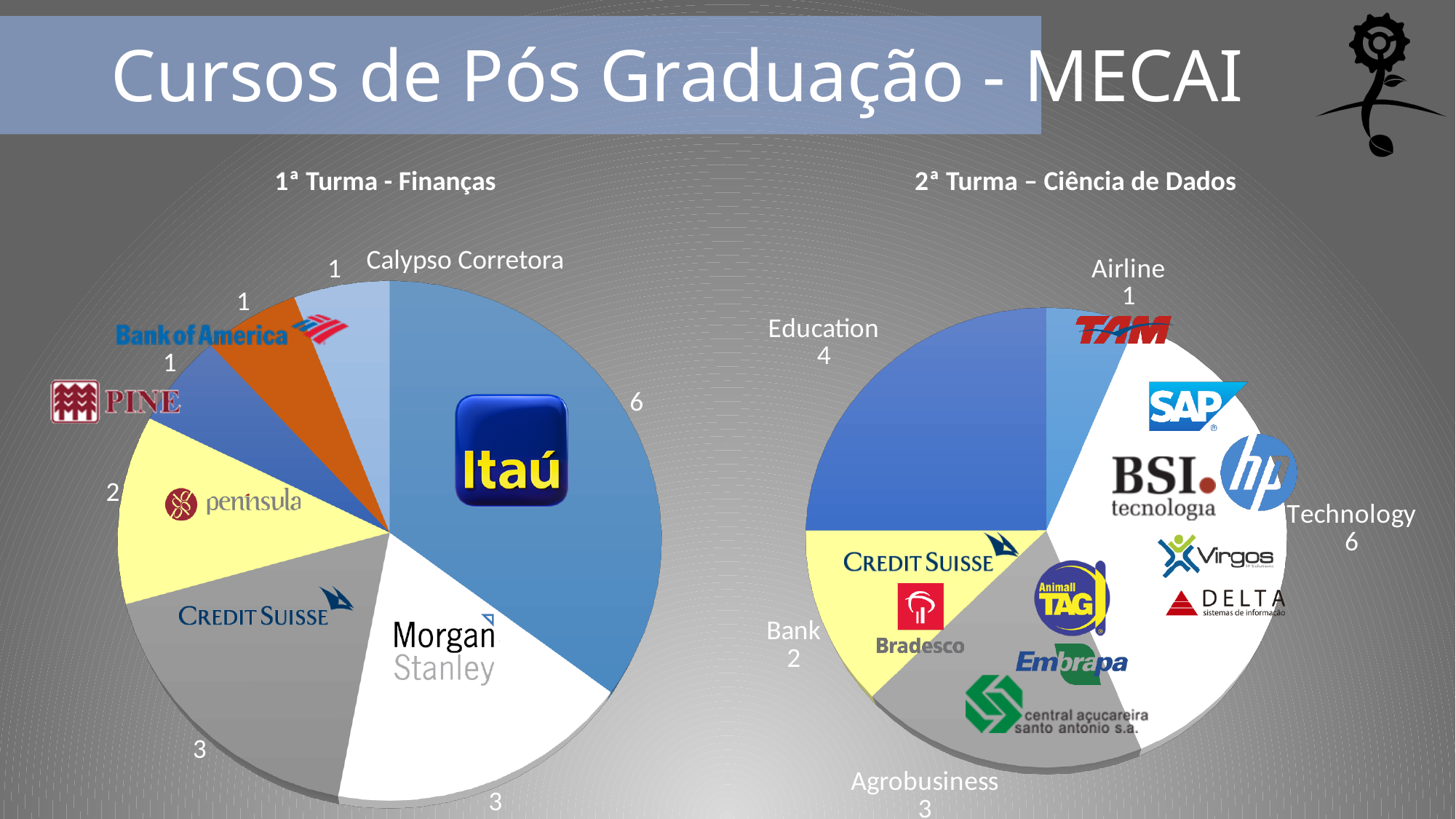
In the "2ª Turma – Ciência de Dados" chart, which category has the smallest slice? Airline In the "2ª Turma – Ciência de Dados" chart, which category has the largest slice? Technology In the "2ª Turma – Ciência de Dados" chart, what is the difference between the Technology and Bank values? 4 In the "2ª Turma – Ciência de Dados" chart, what is the value for Agrobusiness? 3 In the "1ª Turma - Finanças" chart, what is the value for the Itaú slice? 6 How many categories are shown in the "2ª Turma – Ciência de Dados" pie chart? 5 In the "2ª Turma – Ciência de Dados" chart, what is the value for Technology? 6 What kind of chart is used for the "1ª Turma - Finanças" data? pie chart In the "2ª Turma – Ciência de Dados" chart, what is the value for Education? 4 In the "1ª Turma - Finanças" chart, which is larger, the Itaú slice or the Morgan Stanley slice? Itaú What is the title of the pie chart on the right side of the slide? 2ª Turma – Ciência de Dados In the "1ª Turma - Finanças" chart, what is the value for Calypso Corretora? 1